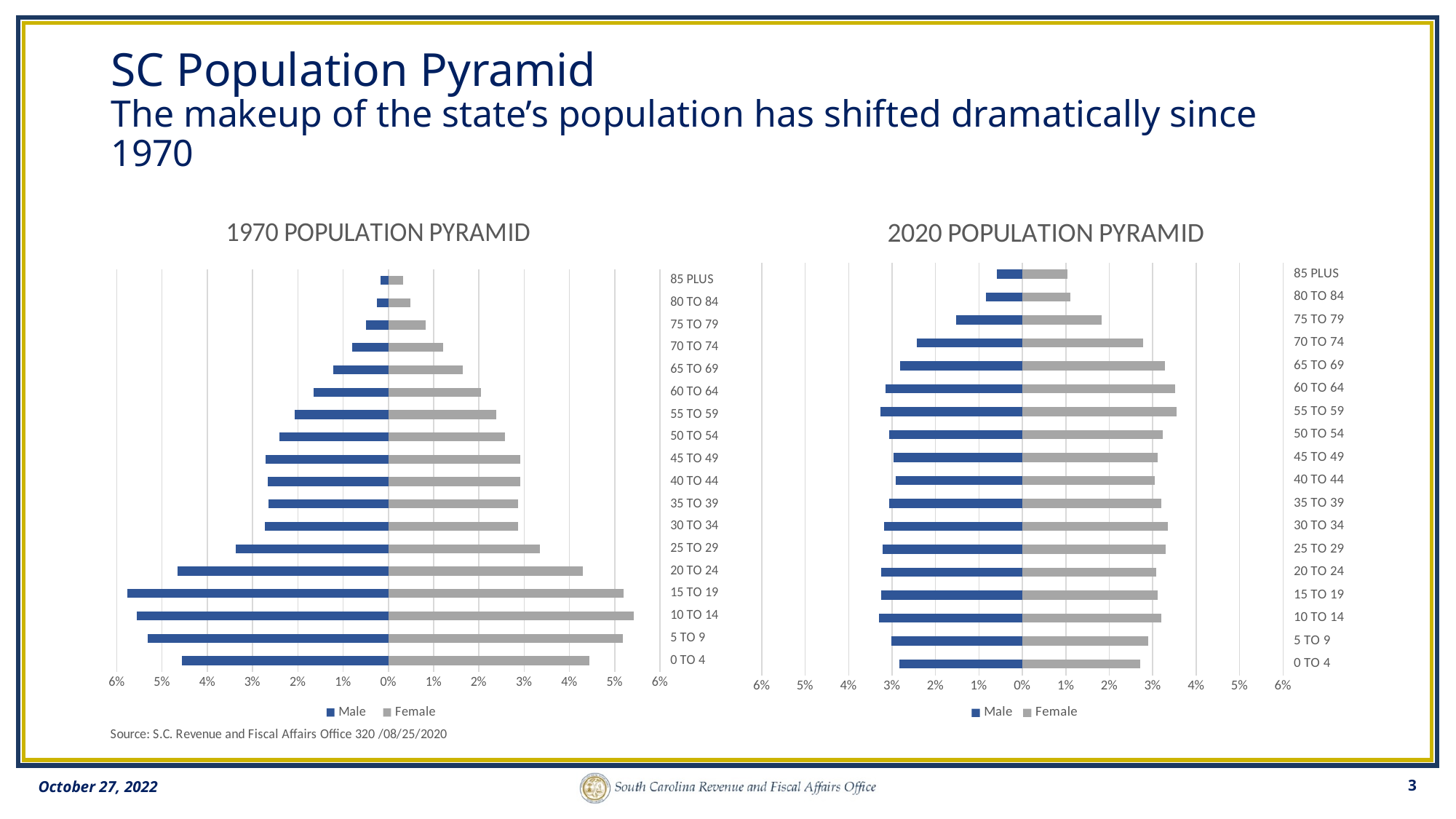
On the 1970 Population Pyramid, is the Male value for 15 TO 19 greater or less than 5%? greater How many age groups are shown on the 2020 Population Pyramid? 18 On the 1970 Population Pyramid, is the Female value for 0 TO 4 greater or less than 4%? greater On the 1970 Population Pyramid, which is larger for Male: 20 TO 24 or 25 TO 29? 20 TO 24 How many series does the legend of the 1970 Population Pyramid list? 2 On the 2020 Population Pyramid, which is larger for Female: 70 TO 74 or 85 PLUS? 70 TO 74 On the 2020 Population Pyramid, is the Female value for 55 TO 59 greater or less than 3%? greater What kind of chart is the 1970 Population Pyramid? bar chart What are the two legend entries on the 2020 Population Pyramid? Male and Female On the 1970 Population Pyramid, which age group has the smallest Male value? 85 PLUS